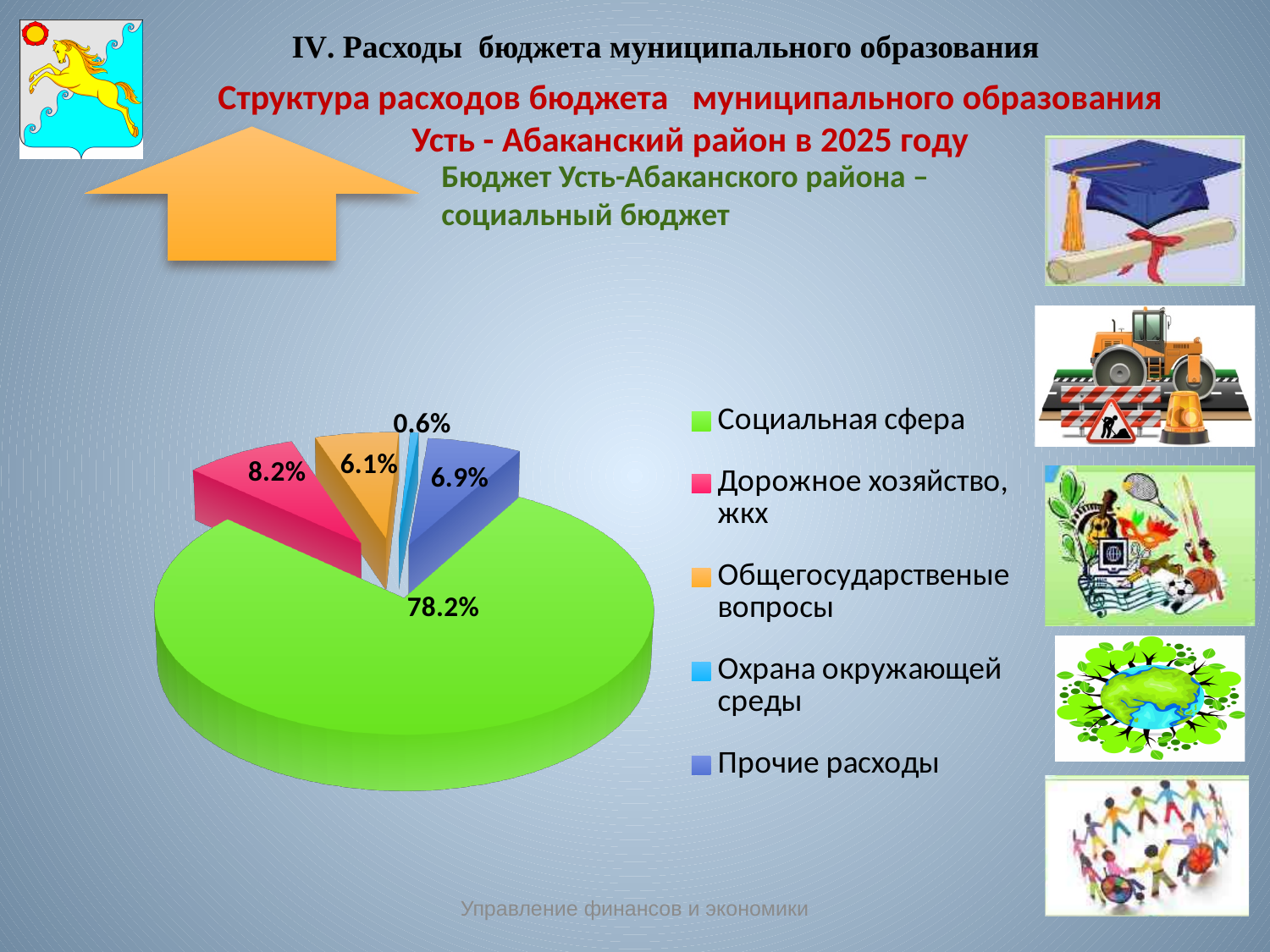
What share of the pie does Дорожное хозяйство, жкх have? 8.2% How many slices does the pie chart have? 5 What is the difference between the shares of Социальная сфера and Дорожное хозяйство, жкх? 70 percentage points Which is larger: the share of Прочие расходы or the share of Общегосударственые вопросы? Прочие расходы Which category has the smallest share of the pie? Охрана окружающей среды What share of the pie does Охрана окружающей среды have? 0.6% What share of the pie does Общегосударственые вопросы have? 6.1% What share of the pie does Социальная сфера have? 78.2% What colour is the slice for Социальная сфера? Green Which category has the largest share of the pie? Социальная сфера What kind of chart is shown on the slide? Pie chart What share of the pie does Прочие расходы have? 6.9%